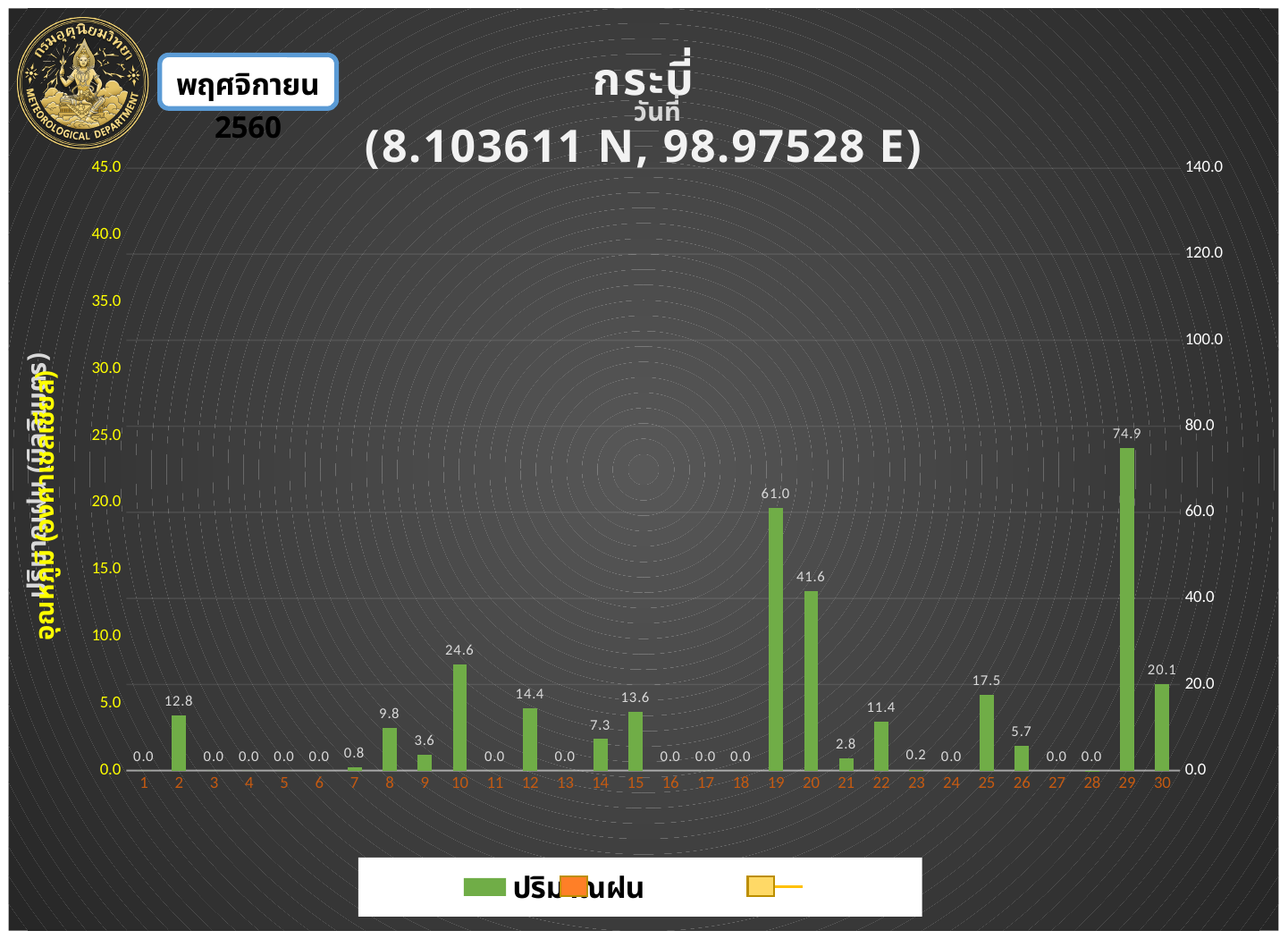
What is the rainfall value shown for day 25? 17.5 What kind of chart is used to show the rainfall data? bar chart Which has a larger rainfall value, day 8 or day 22? day 22 What is the rainfall value shown for day 19? 61.0 Which day has the highest rainfall value? 29 What is the rainfall value shown for day 10? 24.6 How many days are shown on the x axis of the chart? 30 What is the difference between the rainfall values for day 19 and day 20? 19.4 What is the name of the station shown in the chart title? กระบี่ Which has a larger rainfall value, day 12 or day 15? day 12 What is the rainfall value shown for day 29? 74.9 What is the difference between the rainfall values for day 29 and day 30? 54.8